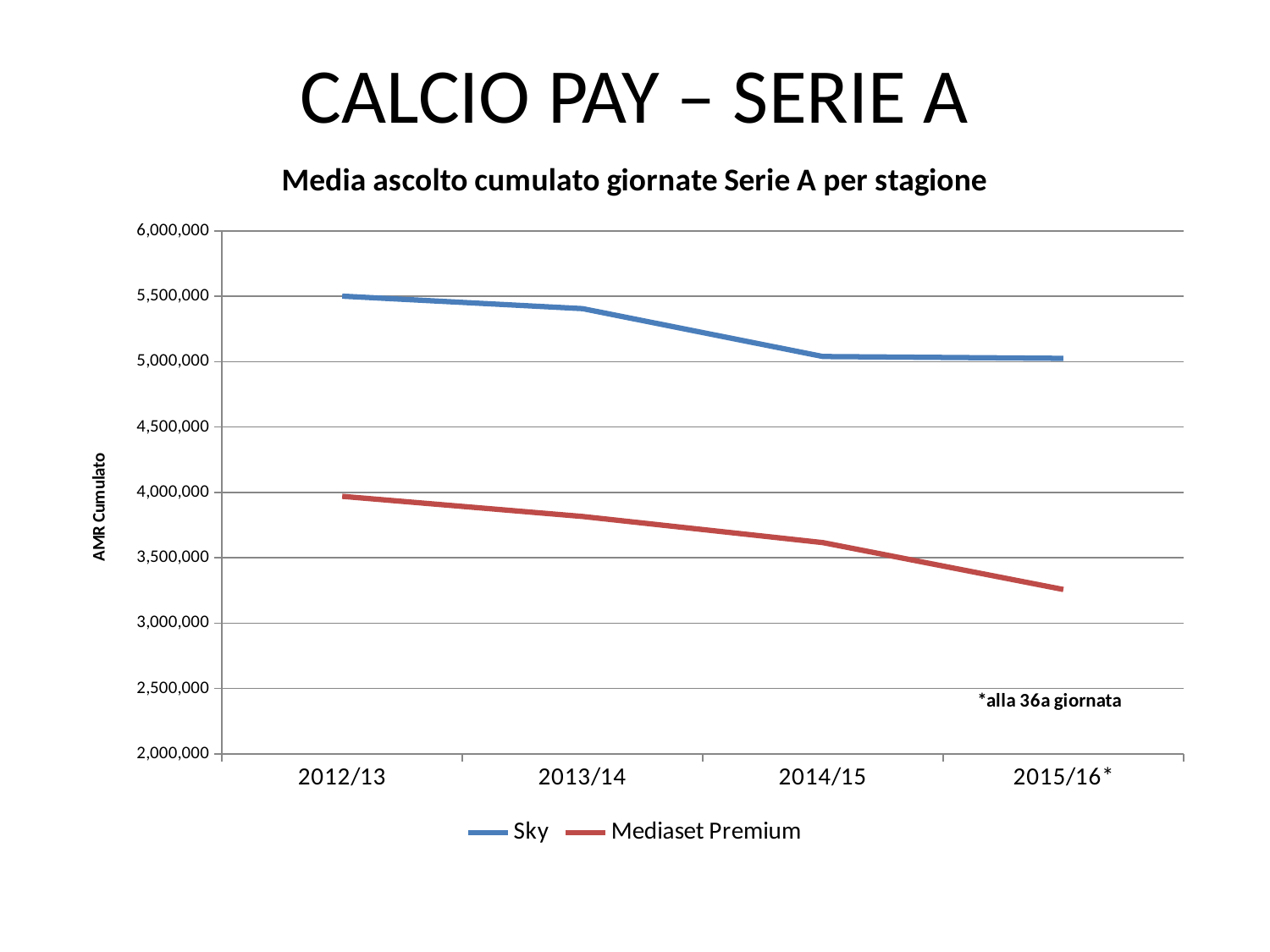
Is the value for Mediaset Premium in 2015/16* greater or less than 3,500,000? less Is the value for Sky in 2013/14 greater or less than 5,500,000? less Is the value for Mediaset Premium in 2013/14 greater or less than 4,000,000? less How many seasons are plotted along the x axis? 4 Which series is higher in 2014/15, Sky or Mediaset Premium? Sky How many series does the legend list? 2 What is the title of the chart? Media ascolto cumulato giornate Serie A per stagione Do the Mediaset Premium values rise or fall from 2012/13 to 2015/16*? fall In which season is the Sky value highest? 2012/13 What kind of chart is shown on the slide? line chart In which season is the Mediaset Premium value lowest? 2015/16*